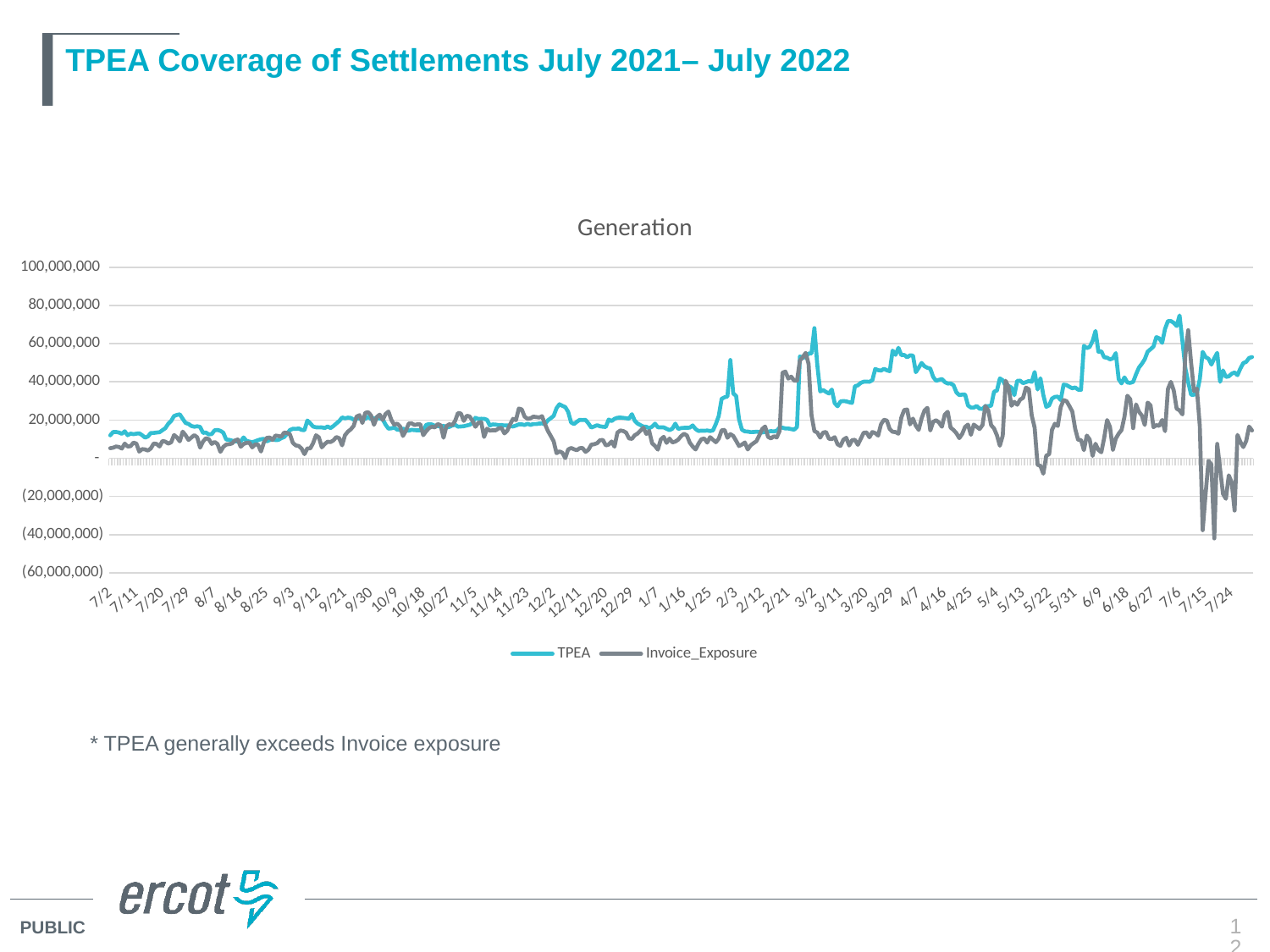
What kind of chart is shown on the slide? Line chart Which series in the Generation chart drops below zero? Invoice_Exposure What is the highest value shown on the vertical axis of the Generation chart? 100,000,000 Which series reaches the highest value in the Generation chart? TPEA Is the peak value of TPEA around 7/6 greater or less than 60,000,000? greater Around 7/15, which series has the higher value, TPEA or Invoice_Exposure? TPEA What are the two series named in the legend of the Generation chart? TPEA and Invoice_Exposure Is the peak of Invoice_Exposure around 3/2 greater or less than 40,000,000? greater Is the value of TPEA at the start of the chart (7/2) greater or less than 20,000,000? less What is the title of the chart on the slide? Generation How many series does the legend of the Generation chart list? 2